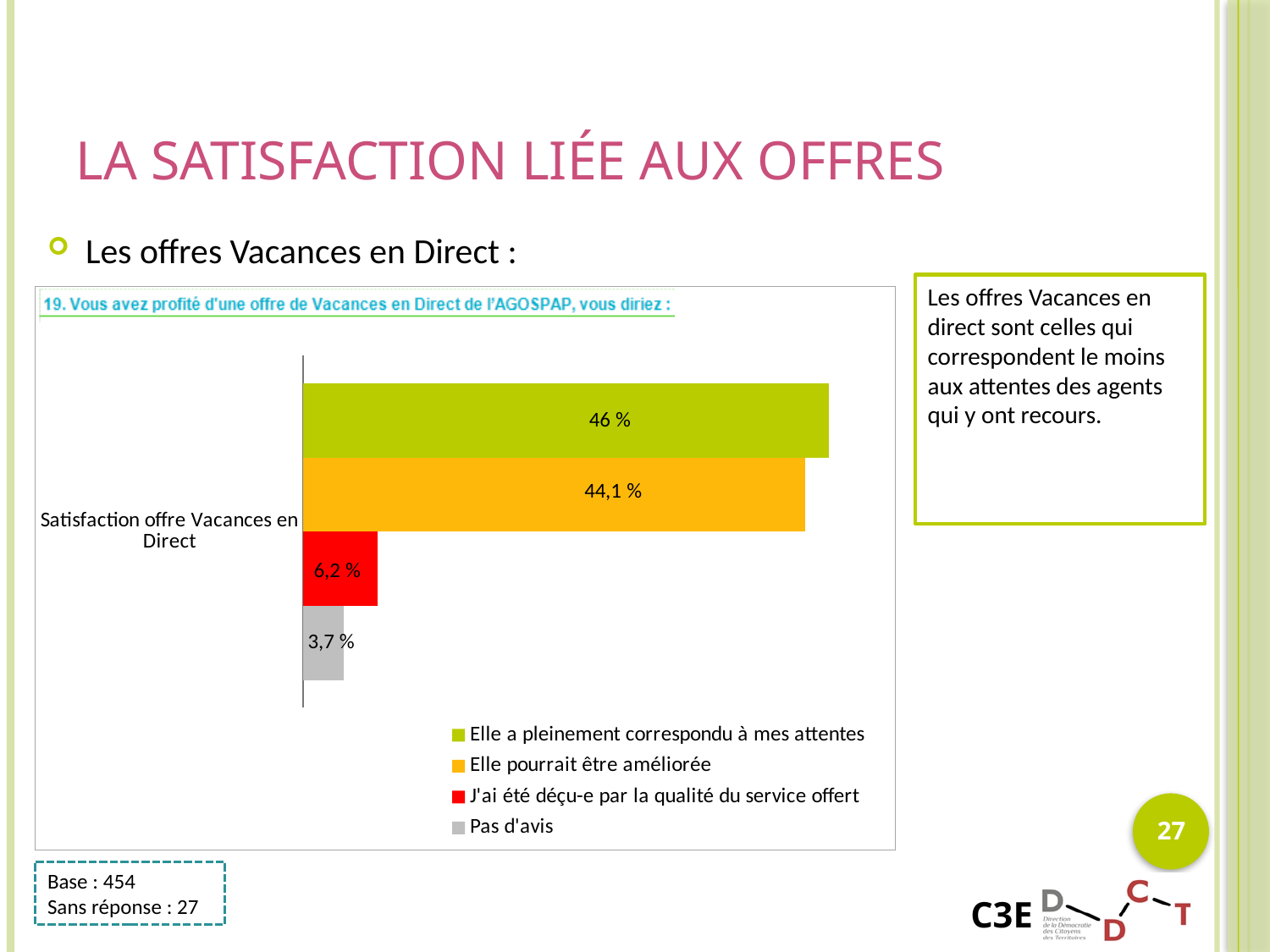
What percentage of respondents said they were disappointed by the quality of the service ("J'ai été déçu-e par la qualité du service offert")? 6,2 % Which response has the lowest value in the chart? Pas d'avis Which is larger: the value for "J'ai été déçu-e par la qualité du service offert" or the value for "Pas d'avis"? J'ai été déçu-e par la qualité du service offert What kind of chart is shown on the slide? Bar chart What percentage of respondents said the Vacances en Direct offer fully met their expectations ("Elle a pleinement correspondu à mes attentes")? 46 % What is the value shown for "Elle pourrait être améliorée"? 44,1 % What is the difference between the values for "J'ai été déçu-e par la qualité du service offert" and "Pas d'avis"? 2,5 % Which response has the highest value in the chart? Elle a pleinement correspondu à mes attentes What colour is the bar for "Elle pourrait être améliorée"? Orange How many series does the legend list? 4 What is the value shown for "Pas d'avis"? 3,7 % What is the difference between the values for "Elle a pleinement correspondu à mes attentes" and "Elle pourrait être améliorée"? 1,9 %